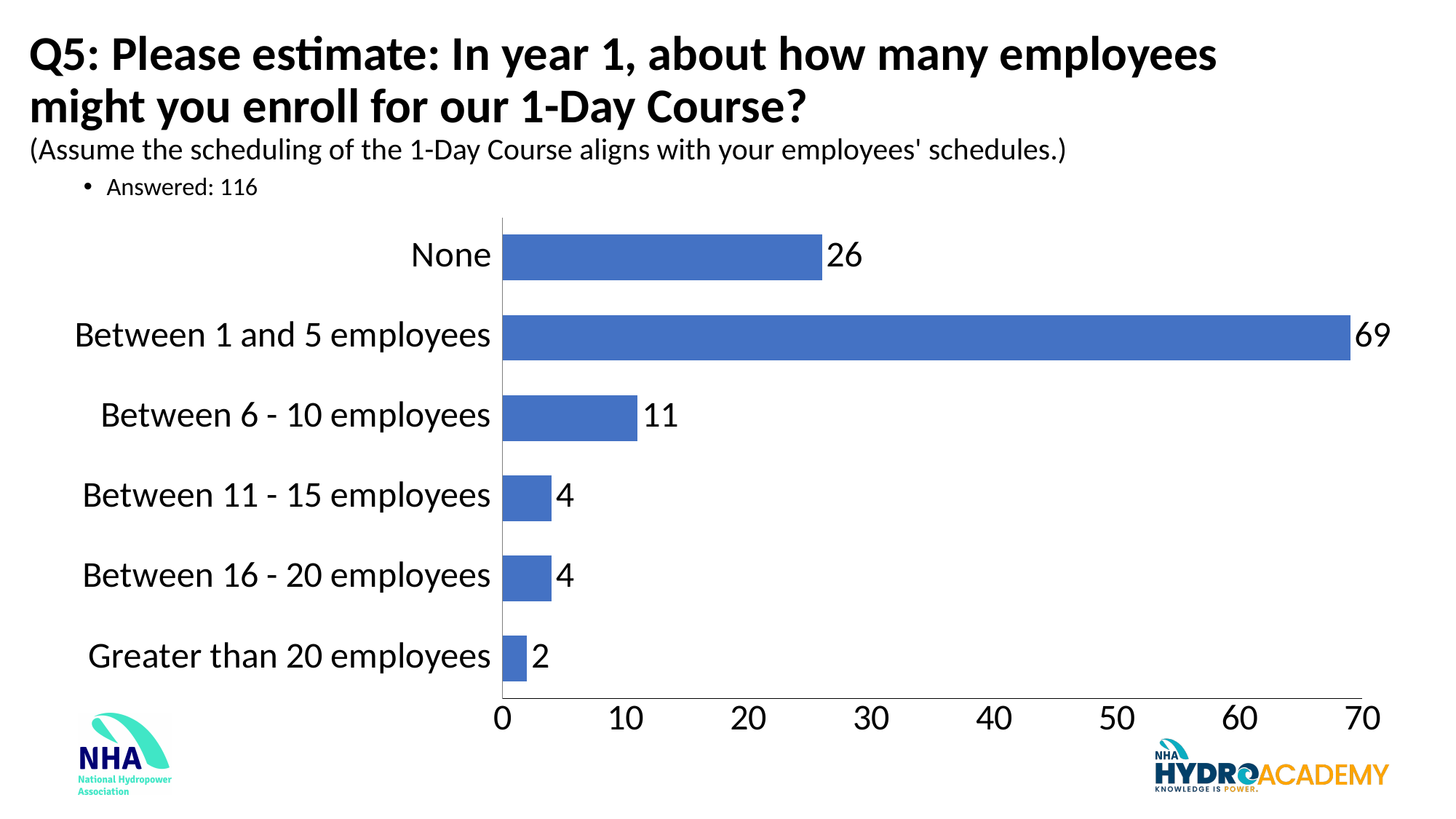
Is the value for "Between 1 and 5 employees" greater or less than 60? greater What is the value for "Between 6 - 10 employees"? 11 Which category has the highest value? Between 1 and 5 employees What kind of chart is shown on the slide? bar chart How many respondents answered the question, according to the slide? 116 Which category has the lowest value? Greater than 20 employees What is the value for "Between 1 and 5 employees"? 69 What is the difference between the values for "Between 1 and 5 employees" and "None"? 43 How many categories are shown in the chart? 6 What is the value for "None"? 26 Which is larger, the value for "None" or the value for "Between 6 - 10 employees"? None What is the value for "Greater than 20 employees"? 2